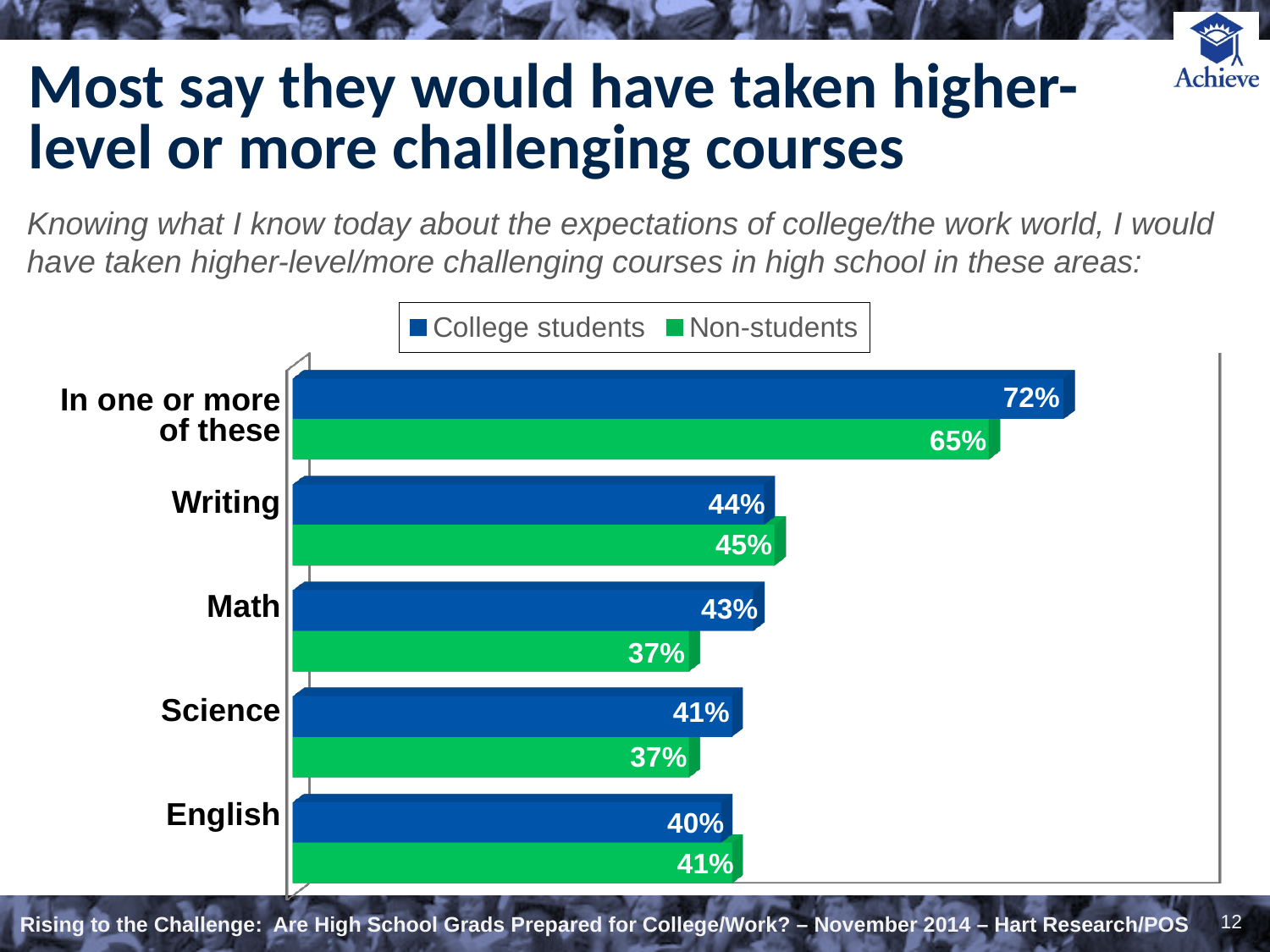
Which category has the highest value for Non-students? In one or more of these How many series does the legend list? 2 What kind of chart is shown on the slide? Bar chart How many course categories are shown on the chart? 5 What is the College students value for 'In one or more of these'? 72% What is the difference between the College students and Non-students values for 'In one or more of these'? 7 percentage points What is the Non-students value for Writing? 45% For English, which group has the larger value, College students or Non-students? Non-students What is the difference between the College students and Non-students values for Math? 6 percentage points What percentage of college students said they would have taken higher-level courses in Math? 43% Which category has the lowest value for College students? English Which colour represents Non-students in the chart? Green